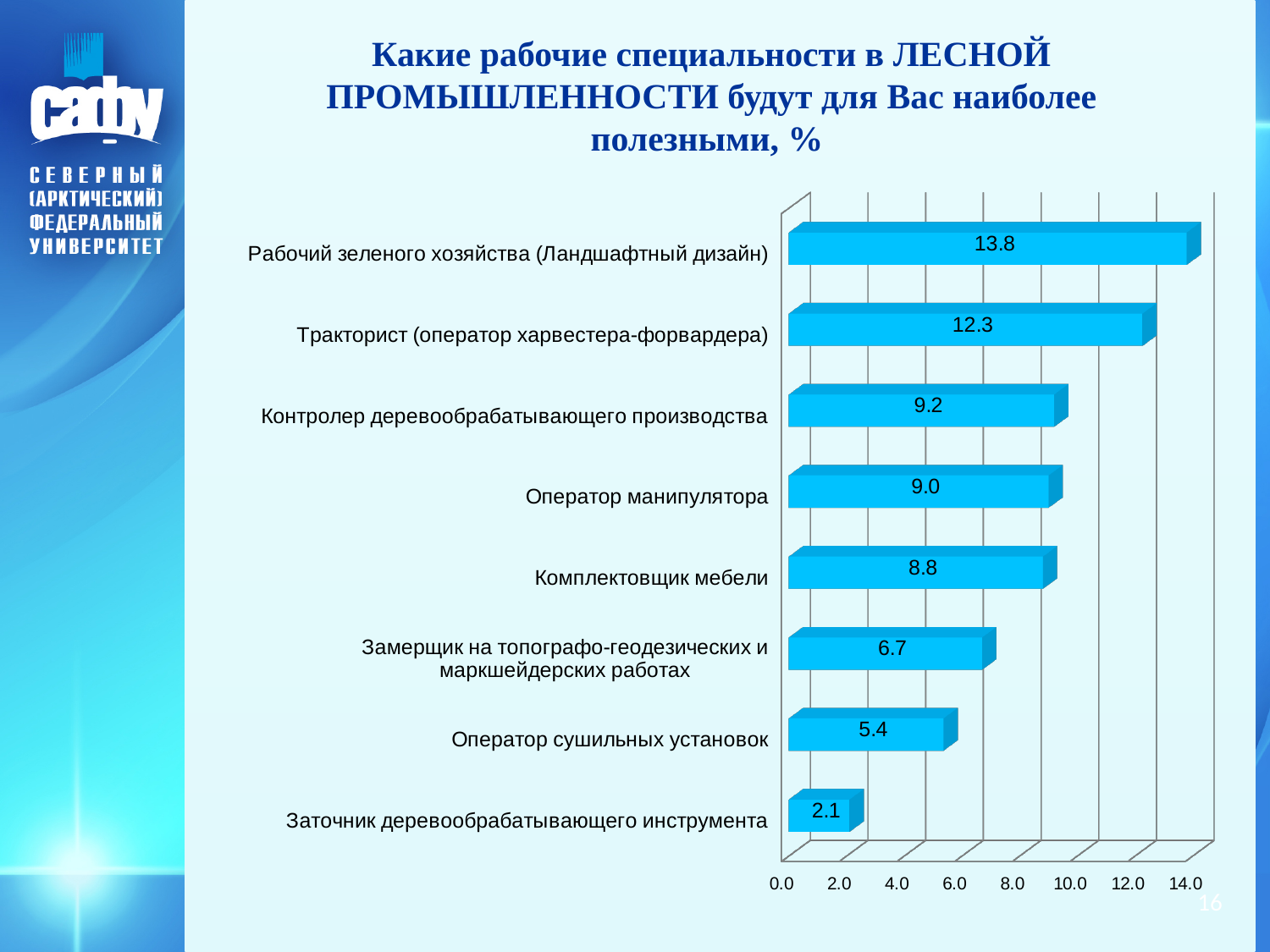
What is the value for Замерщик на топографо-геодезических и маркшейдерских работах? 6.7 What is the value for Оператор сушильных установок? 5.4 Which category has the lowest value? Заточник деревообрабатывающего инструмента What is the value for Рабочий зеленого хозяйства (Ландшафтный дизайн)? 13.8 What kind of chart is shown on the slide? Bar chart What is the difference between the values for Рабочий зеленого хозяйства (Ландшафтный дизайн) and Тракторист (оператор харвестера-форвардера)? 1.5 What is the value for Тракторист (оператор харвестера-форвардера)? 12.3 Which is larger: the value for Контролер деревообрабатывающего производства or the value for Оператор сушильных установок? Контролер деревообрабатывающего производства Which category has the highest value? Рабочий зеленого хозяйства (Ландшафтный дизайн) What is the difference between the values for Комплектовщик мебели and Заточник деревообрабатывающего инструмента? 6.7 How many categories are shown in the chart? 8 What is the highest tick value shown on the horizontal axis? 14.0